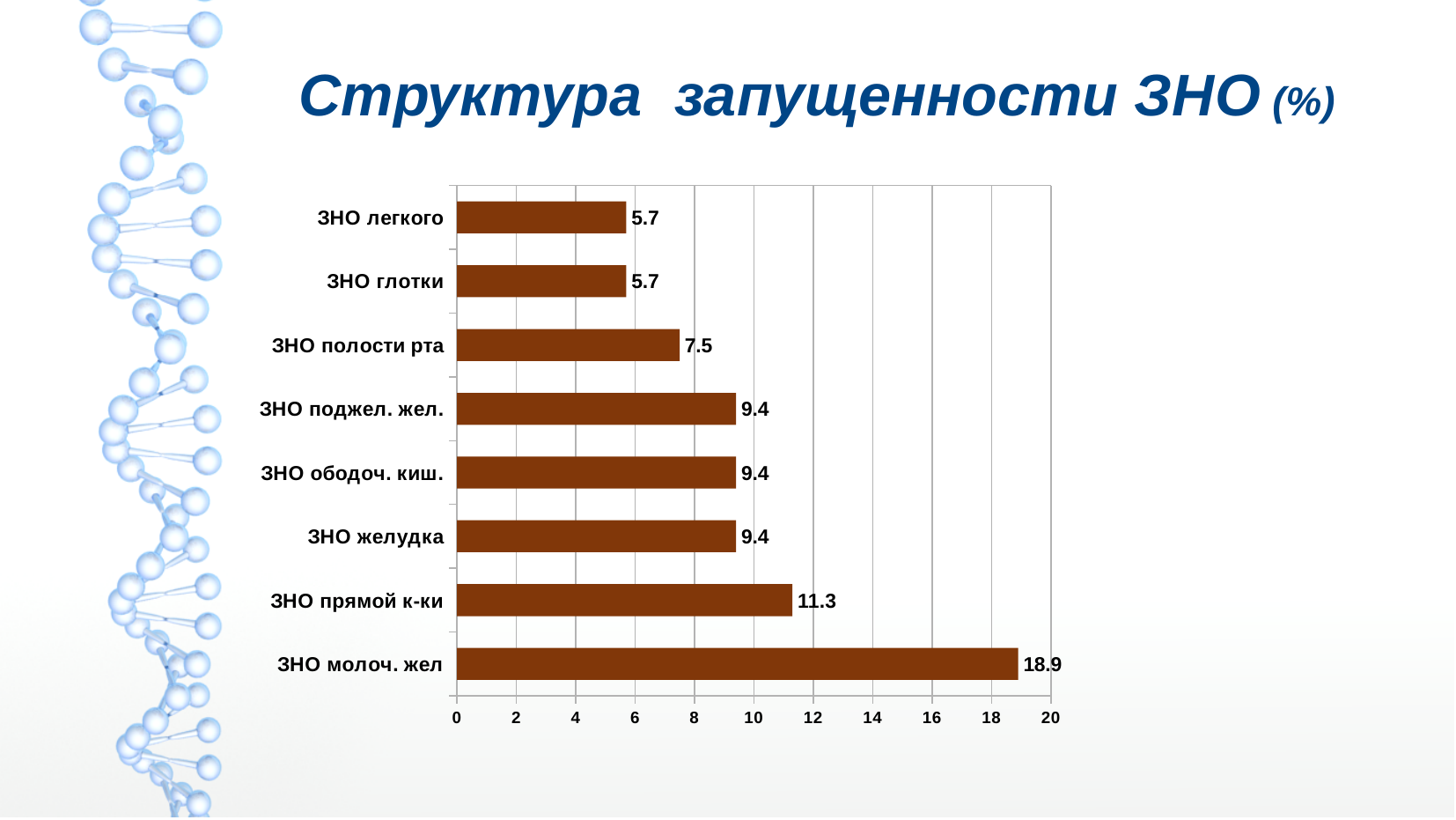
Which is larger, the value for ЗНО полости рта or the value for ЗНО легкого? ЗНО полости рта Is the value for ЗНО прямой к-ки greater or less than 10? greater What is the value for ЗНО желудка? 9.4 What kind of chart is shown on the slide? bar chart What is the value for ЗНО полости рта? 7.5 What is the value for ЗНО прямой к-ки? 11.3 What is the value for ЗНО молоч. жел? 18.9 What is the title of the slide? Структура запущенности ЗНО (%) What is the difference between the values for ЗНО поджел. жел. and ЗНО глотки? 3.7 Which category has the highest value? ЗНО молоч. жел How many categories are shown in the chart? 8 What is the difference between the values for ЗНО молоч. жел and ЗНО прямой к-ки? 7.6